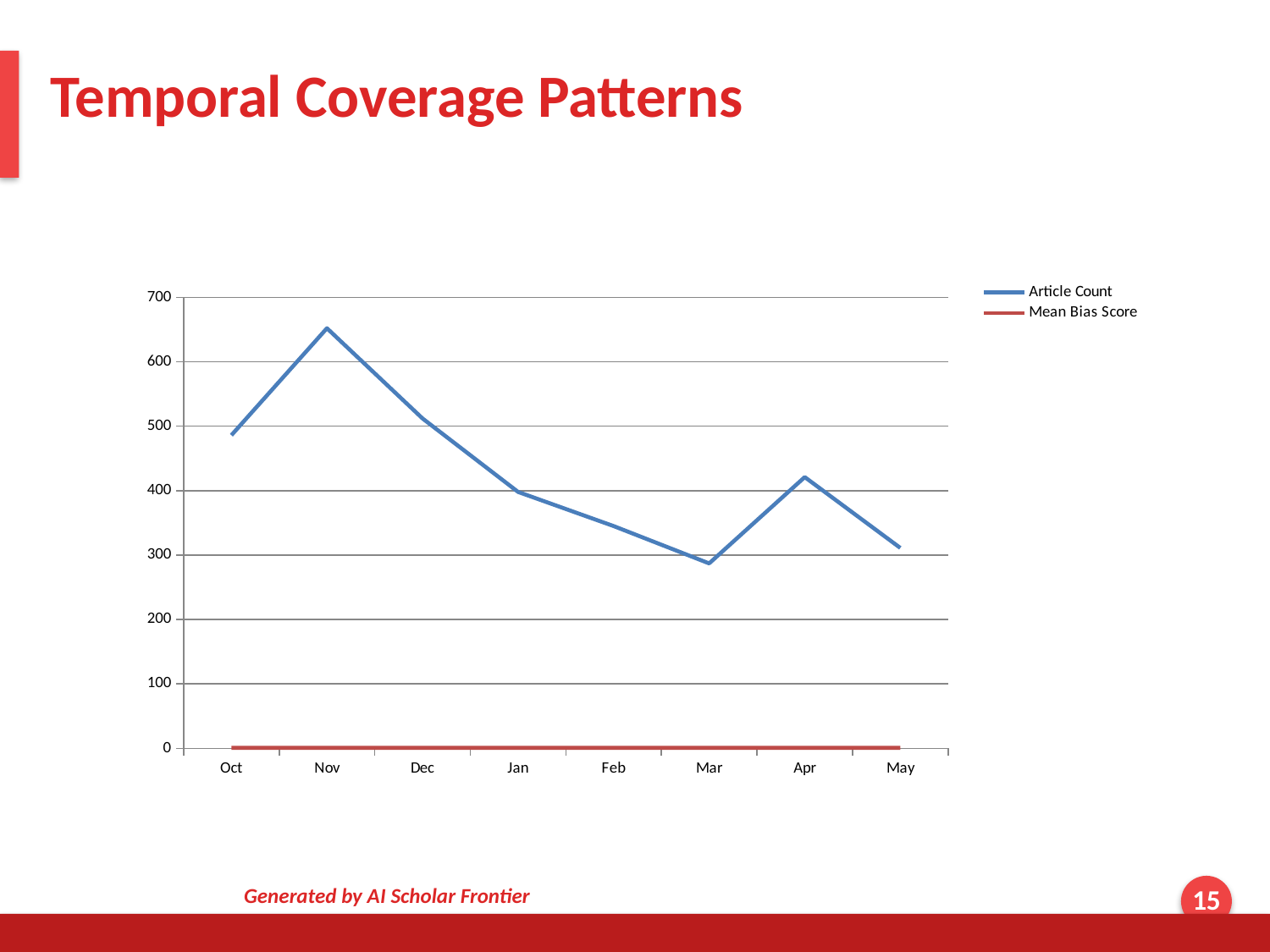
Is the Article Count for Apr greater or less than 400? greater What kind of chart is shown on the slide? line chart In which month is the Article Count lowest? Mar How many months are shown along the x axis? 8 Is the Article Count for Nov greater or less than 600? greater What is the title of the slide? Temporal Coverage Patterns Is the Article Count for Feb greater or less than 400? less How many series does the legend list? 2 In which month is the Article Count highest? Nov Which month has a larger Article Count, Nov or Dec? Nov Does the Article Count rise or fall from Nov to Mar? fall